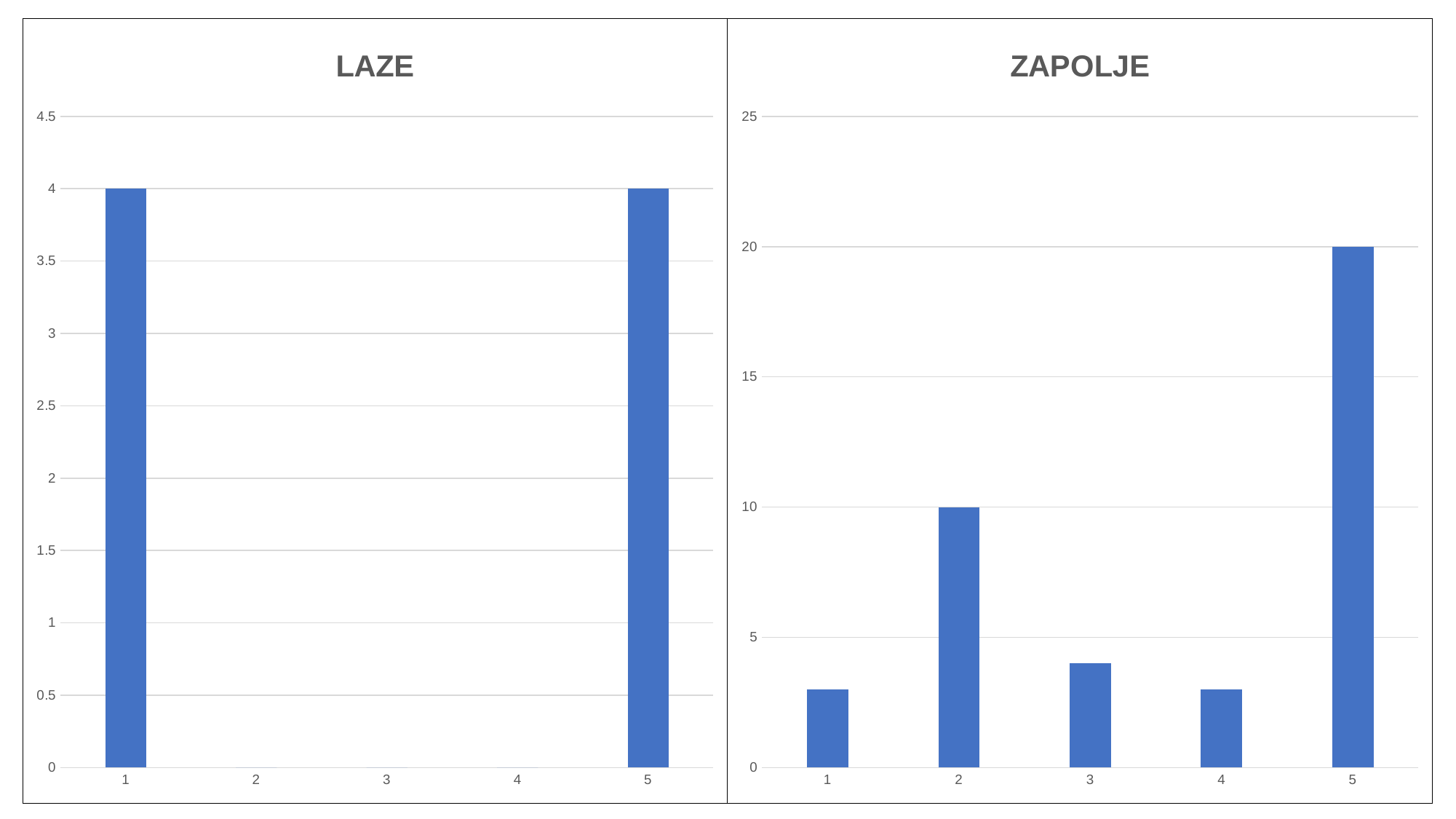
In the ZAPOLJE chart, is the value for category 1 greater or less than 5? less In the ZAPOLJE chart, which is larger, the value for category 2 or category 3? category 2 In the LAZE chart, what is the value for category 5? 4 In the ZAPOLJE chart, which category has the highest value? 5 In the ZAPOLJE chart, what is the value for category 2? 10 In the ZAPOLJE chart, what is the difference between the values for category 5 and category 2? 10 In the ZAPOLJE chart, what is the value for category 5? 20 What is the title of the chart on the right side of the slide? ZAPOLJE In the ZAPOLJE chart, is the value for category 3 greater or less than 5? less What kind of chart is the LAZE chart? bar chart How many categories are shown on the x axis of the ZAPOLJE chart? 5 In the LAZE chart, what is the value for category 1? 4